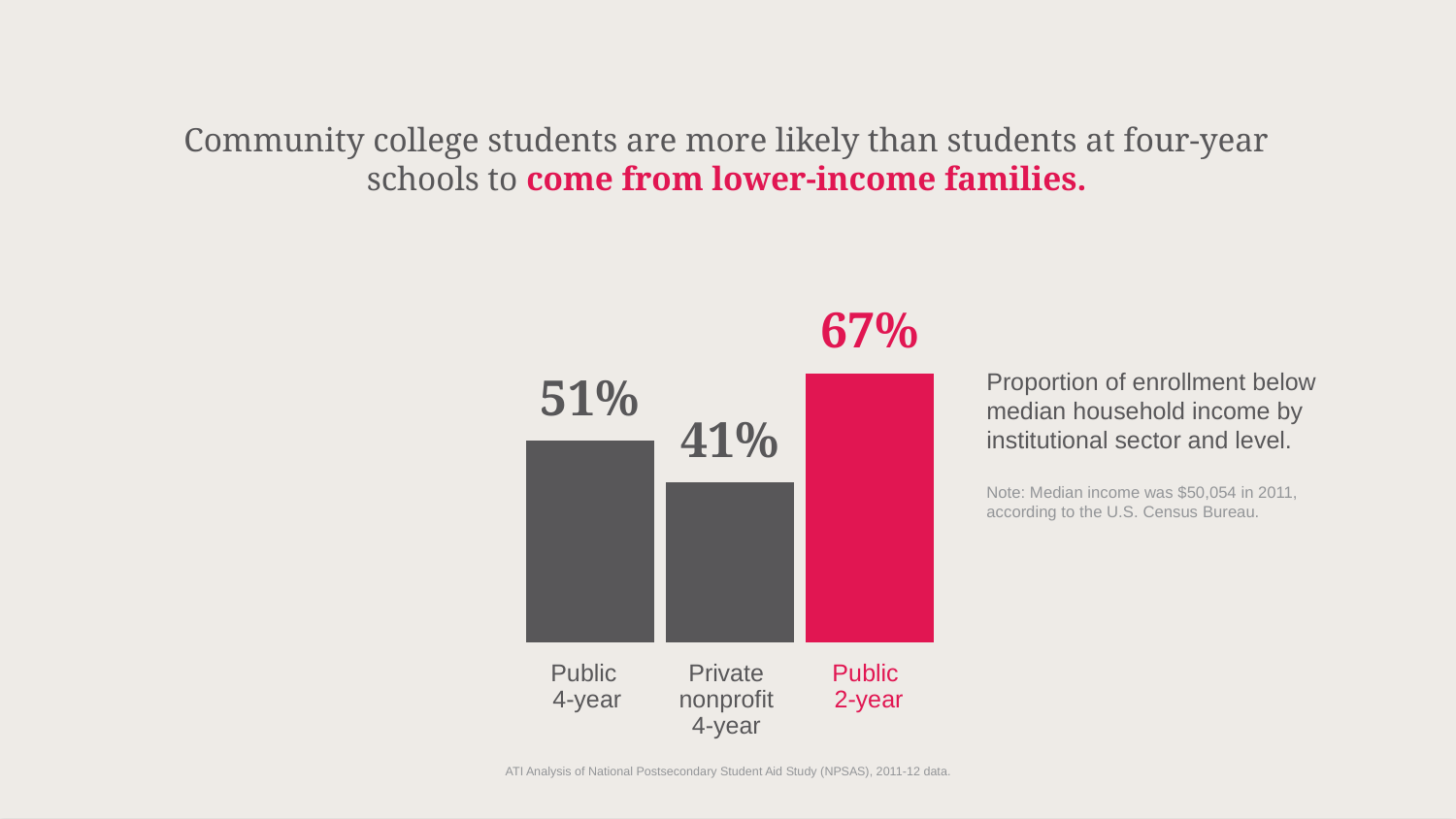
Which bar is highlighted in a different colour (red) from the others? Public 2-year What is the difference between the values for Public 4-year and Private nonprofit 4-year? 10% Which category has the lowest value? Private nonprofit 4-year What is the value for Public 4-year? 51% According to the note on the slide, what was the median income in 2011? $50,054 What is the value for Private nonprofit 4-year? 41% What kind of chart is shown on the slide? Bar chart Which category has the highest value? Public 2-year Which is larger, the value for Public 4-year or the value for Private nonprofit 4-year? Public 4-year What is the difference between the values for Public 2-year and Public 4-year? 16% What is the value for Public 2-year? 67% How many categories are shown in the chart? 3